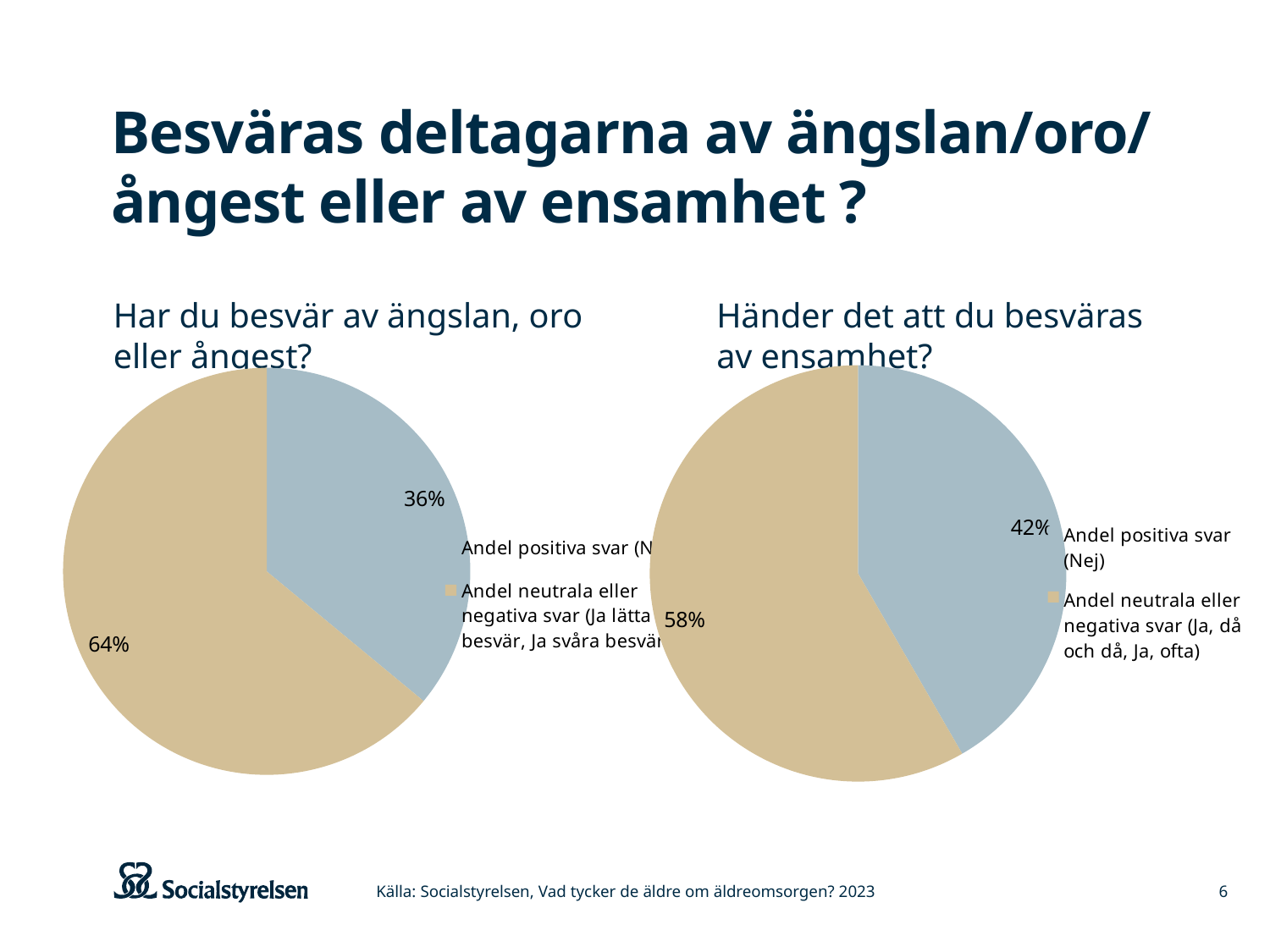
Is the share of positive answers (Nej) larger in the left chart 'Har du besvär av ängslan, oro eller ångest?' or in the right chart 'Händer det att du besväras av ensamhet?'? The right chart (Händer det att du besväras av ensamhet?) In the right chart 'Händer det att du besväras av ensamhet?', what is the difference in percentage points between the neutral/negative share and the positive share? 16 percentage points How many slices does the right chart 'Händer det att du besväras av ensamhet?' have? 2 In the left chart 'Har du besvär av ängslan, oro eller ångest?', what share of answers are positive (Nej)? 36% How many entries does the legend of the right chart 'Händer det att du besväras av ensamhet?' list? 2 In the right chart 'Händer det att du besväras av ensamhet?', what share of answers are positive (Nej)? 42% What type of chart is used on this slide? Pie chart In the left chart 'Har du besvär av ängslan, oro eller ångest?', what share of answers are neutral or negative? 64% In the right chart 'Händer det att du besväras av ensamhet?', what share of answers are neutral or negative? 58% In the left chart 'Har du besvär av ängslan, oro eller ångest?', what is the difference in percentage points between the neutral/negative share and the positive share? 28 percentage points In the left chart 'Har du besvär av ängslan, oro eller ångest?', which slice is the largest? Andel neutrala eller negativa svar In the right chart 'Händer det att du besväras av ensamhet?', which slice is the smallest? Andel positiva svar (Nej)